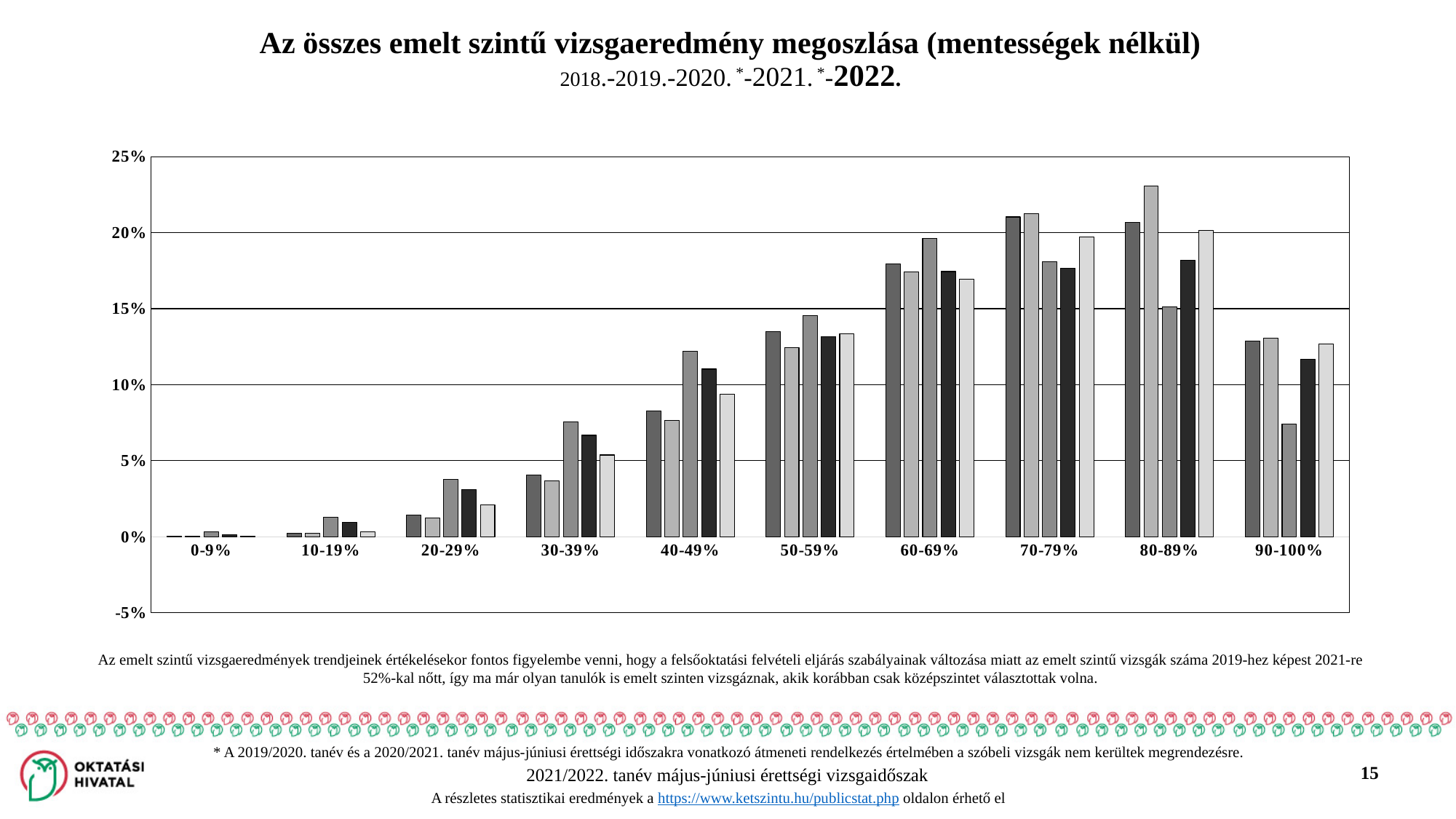
Is the tallest bar in the 80-89% group greater or less than 20%? greater In the 90-100% group, which is taller: the first (leftmost) bar or the third bar? the first bar How many score-band categories are shown on the x axis? 10 Is the tallest bar in the 30-39% group greater or less than 10%? less How many bars are plotted for each score-band category? 5 Is the shortest bar in the 60-69% group greater or less than 15%? greater What is the highest value labelled on the vertical axis? 25% What kind of chart is shown on the slide? bar chart Which score-band category has the lowest bars in the chart? 0-9% Do the bar heights generally rise or fall from the 0-9% category to the 80-89% category? rise Which score-band category contains the tallest bar in the chart? 80-89%